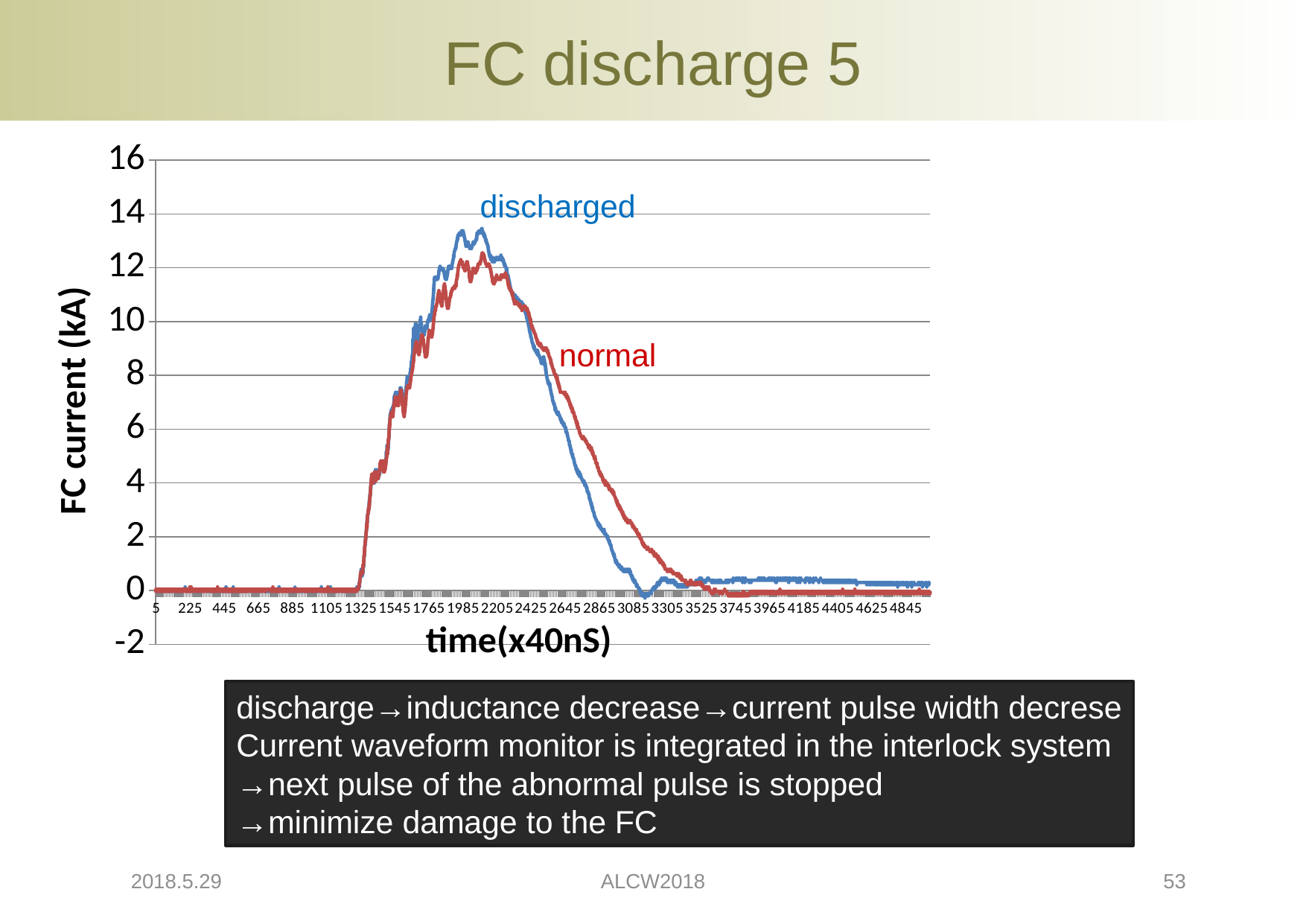
What is the highest value shown on the y axis of the chart? 16 What is the label of the x axis of the chart? time(x40nS) Is the peak value of the normal series greater or less than 10 kA? greater Is the peak value of the discharged series greater or less than 14 kA? less What kind of chart is shown on the slide? line chart How many series are plotted on the chart? 2 Is the value of the normal series at time 885 greater or less than 2 kA? less Which series reaches the higher peak current, discharged or normal? discharged What is the label of the y axis of the chart? FC current (kA) Which series falls back to zero earlier in time, discharged or normal? discharged